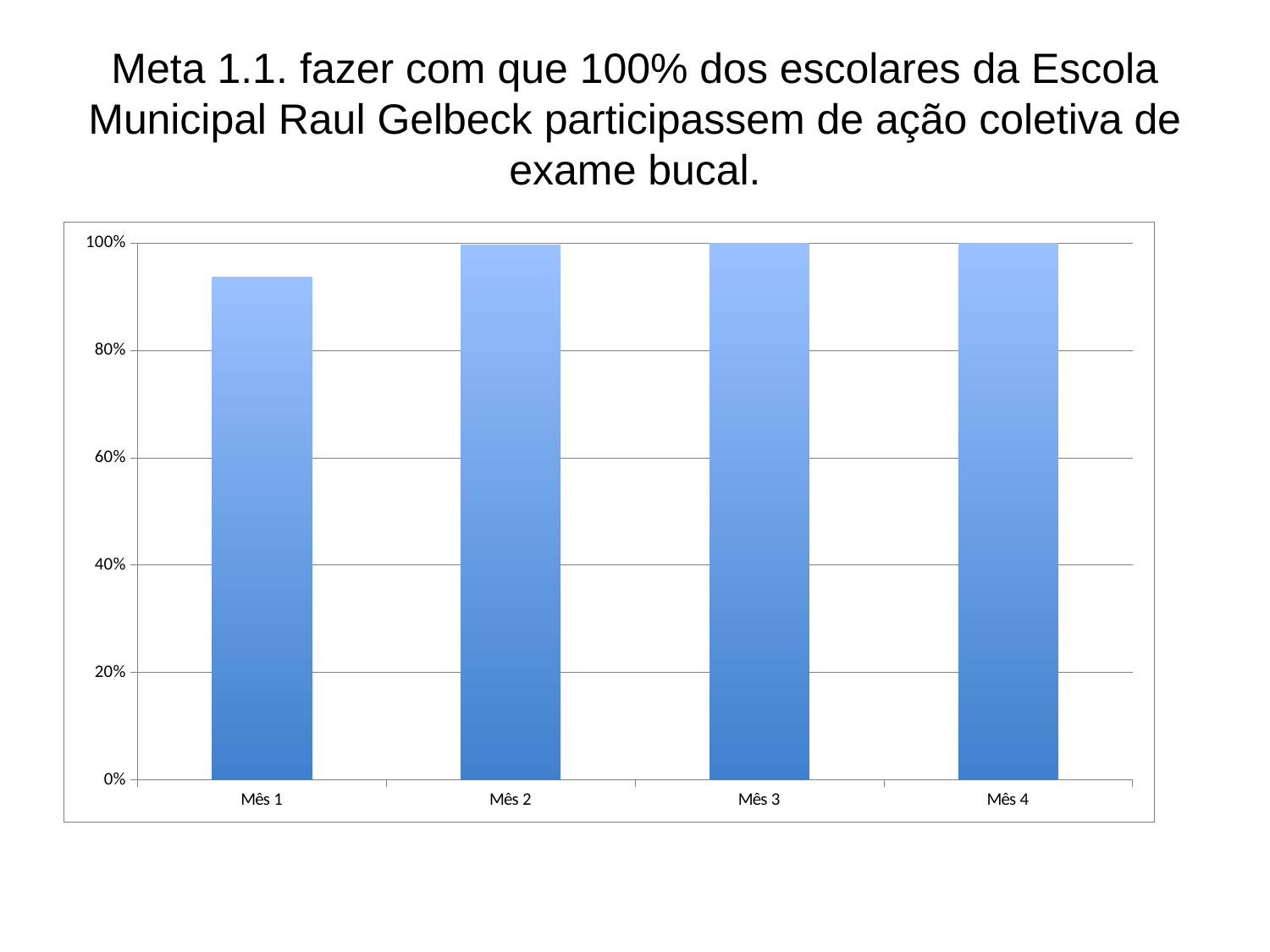
Which is larger, the value for Mês 1 or the value for Mês 3? Mês 3 What colour are the bars in the chart? blue Is the value for Mês 1 greater or less than 80%? greater How many categories (months) are shown on the x axis of the chart? 4 What kind of chart is shown on the slide? bar chart Which is larger, the value for Mês 1 or the value for Mês 4? Mês 4 Is the value for Mês 3 greater or less than 80%? greater Is the value for Mês 1 greater or less than 100%? less Which month has the lowest bar in the chart? Mês 1 What is the highest value shown on the y axis of the chart? 100% Do the values generally rise or fall from Mês 1 to Mês 4? rise